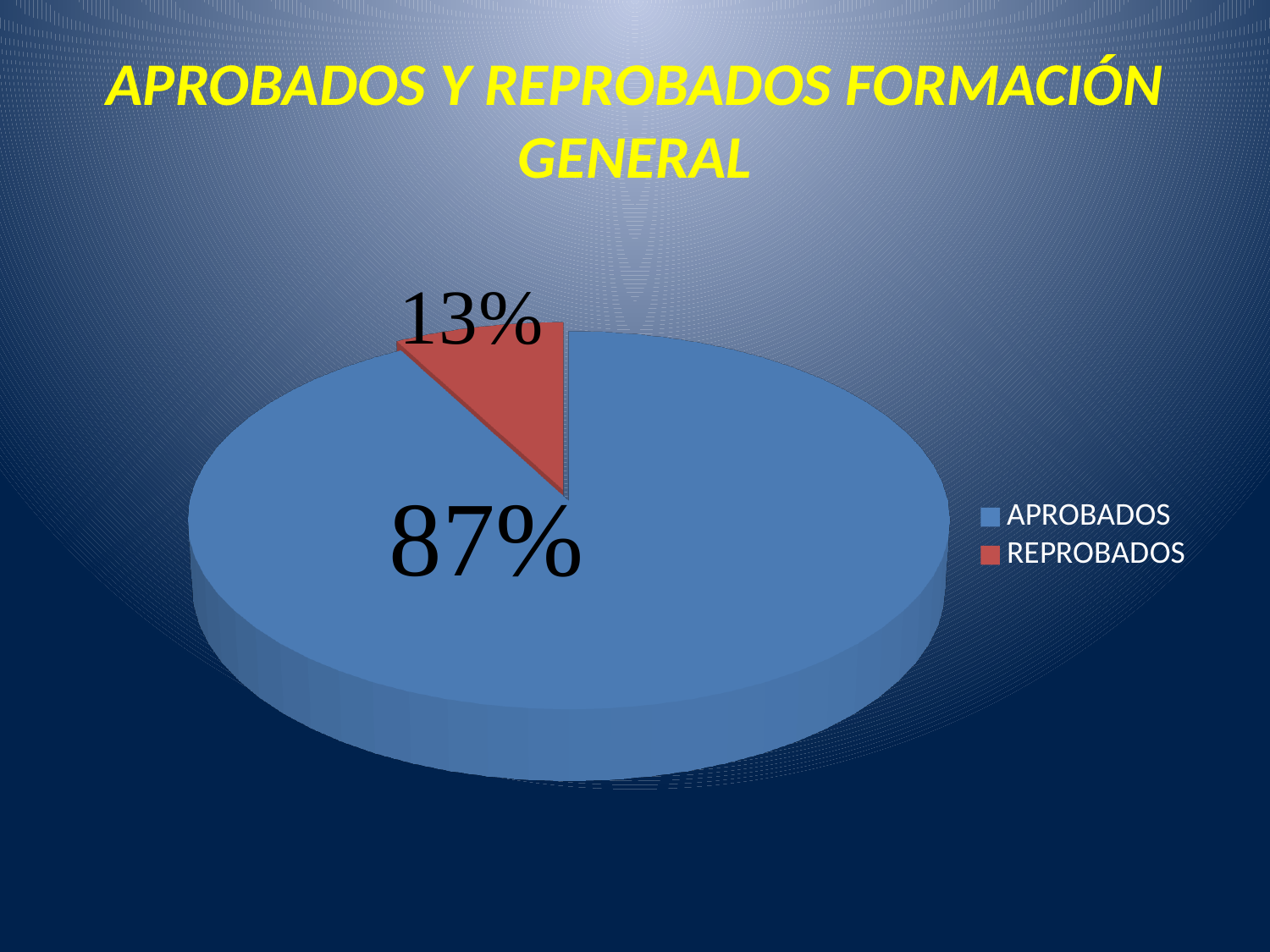
Which is larger, the share for APROBADOS or the share for REPROBADOS? APROBADOS How many slices does the pie chart have? 2 What colour is the REPROBADOS slice? Red Which category has the smallest share of the pie? REPROBADOS What kind of chart is shown on the slide? Pie chart What percentage of the pie is REPROBADOS? 13% How many entries does the legend list? 2 What percentage of the pie is APROBADOS? 87% What is the title of the chart? APROBADOS Y REPROBADOS FORMACIÓN GENERAL What is the difference in percentage points between APROBADOS and REPROBADOS? 74 Which category has the largest share of the pie? APROBADOS